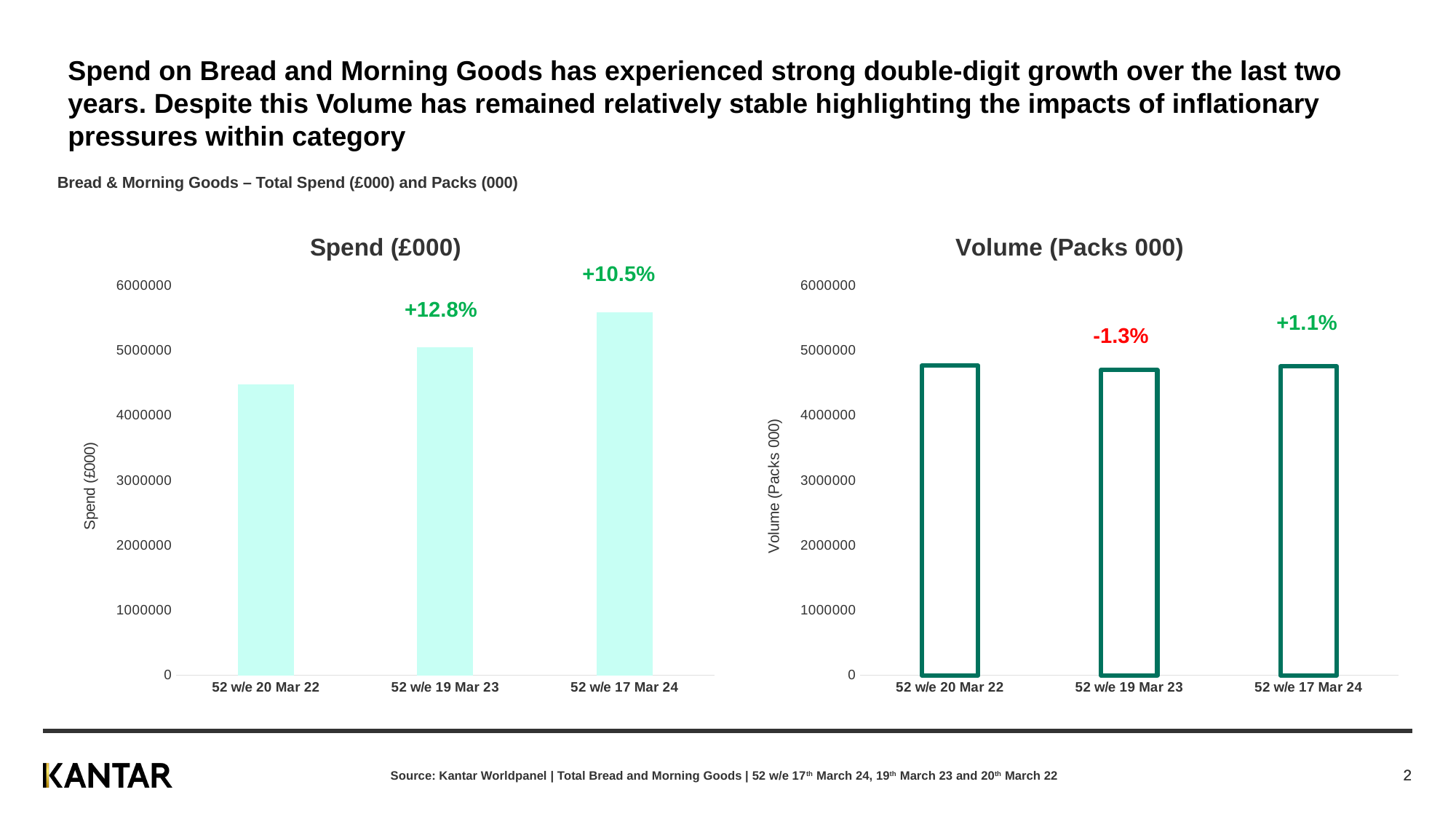
On the Spend (£000) chart, what growth percentage is shown above the bar for 52 w/e 19 Mar 23? +12.8% On the Volume (Packs 000) chart, what growth percentage is shown above the bar for 52 w/e 17 Mar 24? +1.1% On the Spend (£000) chart, is the value for 52 w/e 20 Mar 22 greater or less than 5000000? less On the Volume (Packs 000) chart, is the value for 52 w/e 19 Mar 23 greater or less than 5000000? less On the Spend (£000) chart, is the value for 52 w/e 17 Mar 24 greater or less than 5000000? greater On the Volume (Packs 000) chart, what growth percentage is shown above the bar for 52 w/e 19 Mar 23? -1.3% On the Spend (£000) chart, what growth percentage is shown above the bar for 52 w/e 17 Mar 24? +10.5% On the Spend (£000) chart, which period has the lowest spend? 52 w/e 20 Mar 22 On the Spend (£000) chart, which period has the highest spend? 52 w/e 17 Mar 24 How many periods are plotted on the Spend (£000) chart? 3 On the Spend (£000) chart, do the values rise or fall from 52 w/e 20 Mar 22 to 52 w/e 17 Mar 24? rise